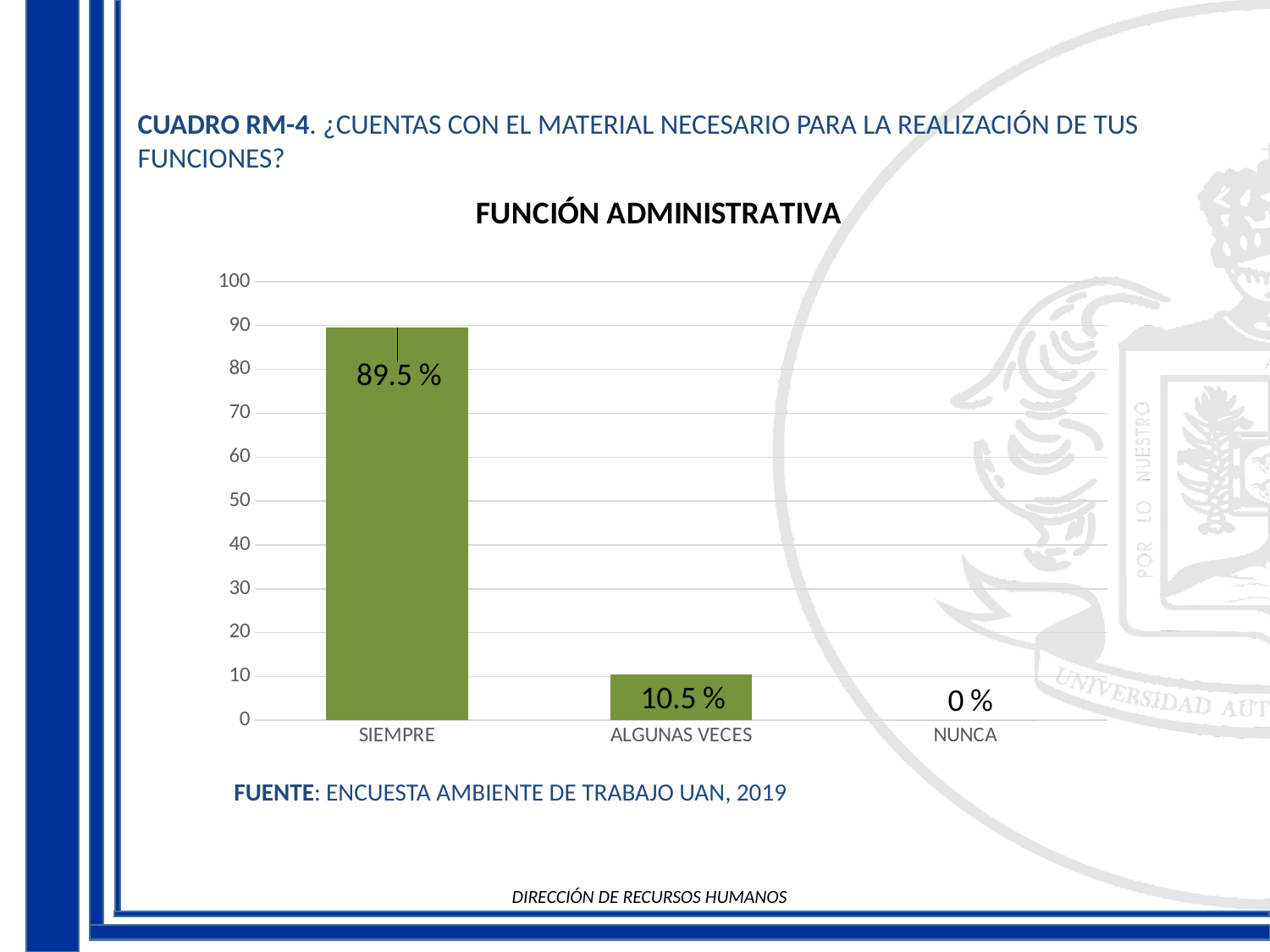
What is the difference between the values for SIEMPRE and ALGUNAS VECES? 79 % Which is larger, the value for ALGUNAS VECES or the value for NUNCA? ALGUNAS VECES Which category has the lowest value? NUNCA What is the title of the chart? FUNCIÓN ADMINISTRATIVA What is the value for ALGUNAS VECES? 10.5 % Is the value for SIEMPRE greater or less than 80? greater How many categories are shown on the x axis? 3 Is the value for ALGUNAS VECES greater or less than 20? less What kind of chart is shown? bar chart Which category has the highest value? SIEMPRE What is the value for NUNCA? 0 % What is the value for SIEMPRE? 89.5 %